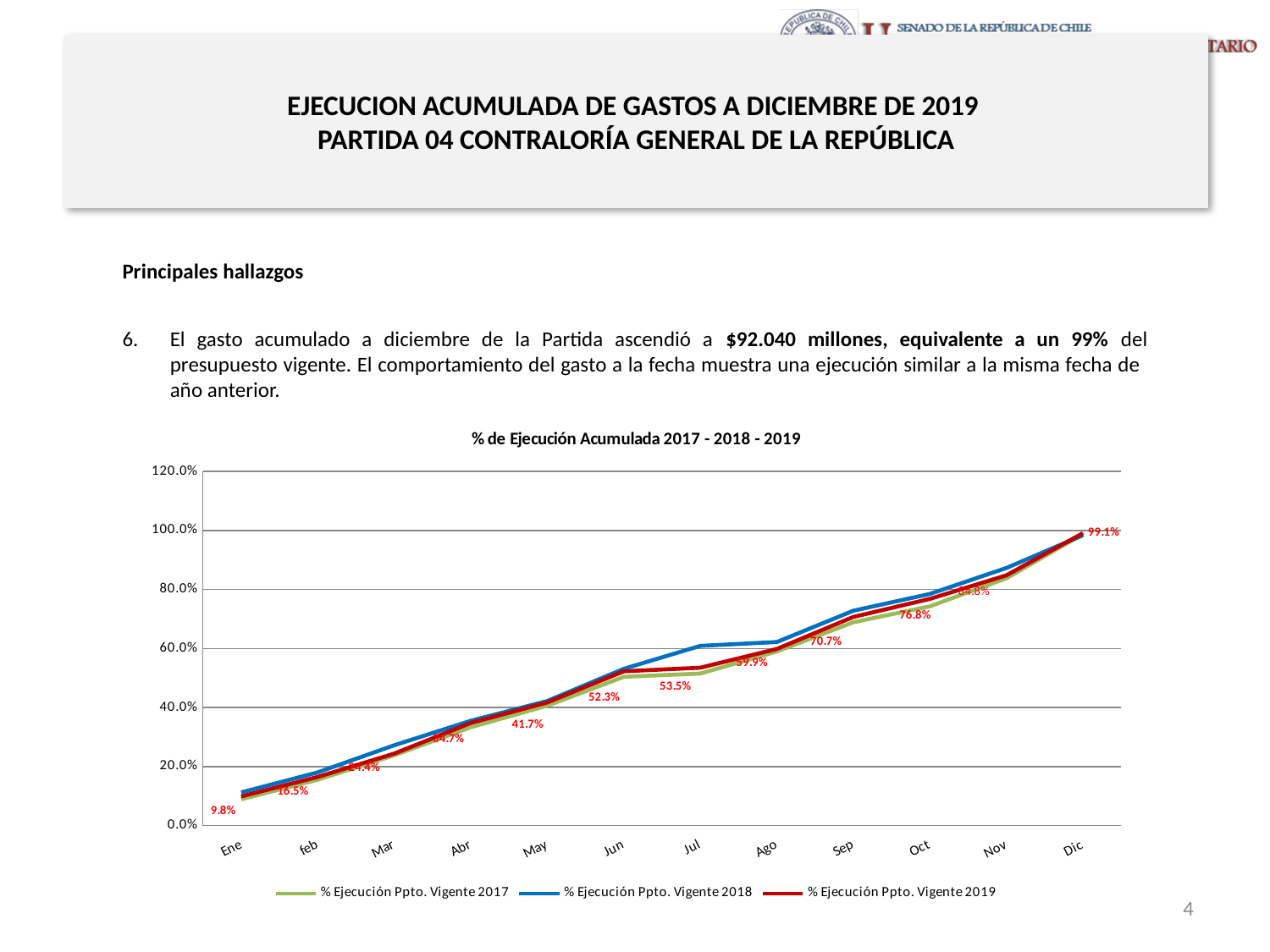
In the 2019 series, what is the difference between the Jul value and the Jun value? 1.2% What is the value for Ene in the series % Ejecución Ppto. Vigente 2019? 9.8% What kind of chart is shown on the slide? line chart What is the value for Dic in the series % Ejecución Ppto. Vigente 2019? 99.1% What is the title of the chart? % de Ejecución Acumulada 2017 - 2018 - 2019 How many series does the legend of the chart list? 3 How many months are plotted along the x axis of the chart? 12 Is the value for Jul in the series % Ejecución Ppto. Vigente 2017 greater or less than 60.0%? less What is the value for Sep in the series % Ejecución Ppto. Vigente 2019? 70.7% What is the value for Jun in the series % Ejecución Ppto. Vigente 2019? 52.3% In the 2019 series, by how much does the Dic value exceed the Ene value? 89.3% Do the values of the 2019 series rise or fall from Ene to Dic? rise